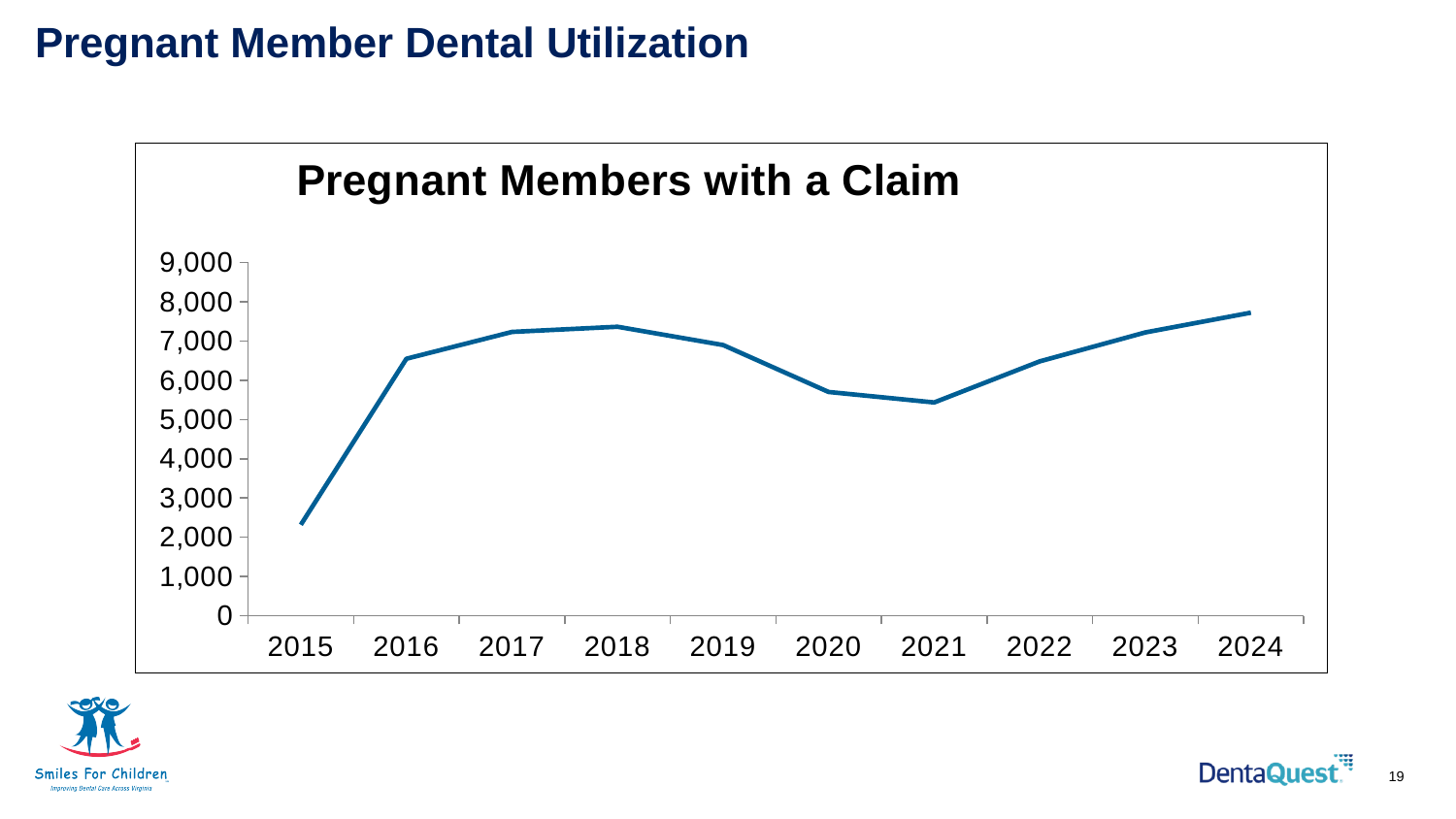
Which year has the highest number of pregnant members with a claim? 2024 Which year has the larger value, 2021 or 2023? 2023 Is the value for 2015 greater or less than 3,000? less Is the value for 2024 greater or less than 7,000? greater Is the value for 2016 greater or less than 6,000? greater What kind of chart is shown on the slide? line chart What is the title of the chart? Pregnant Members with a Claim Do the values rise or fall from 2021 to 2024? rise Which year has the lowest number of pregnant members with a claim? 2015 How many years are plotted on the x axis of the chart? 10 Which year has the larger value, 2019 or 2020? 2019